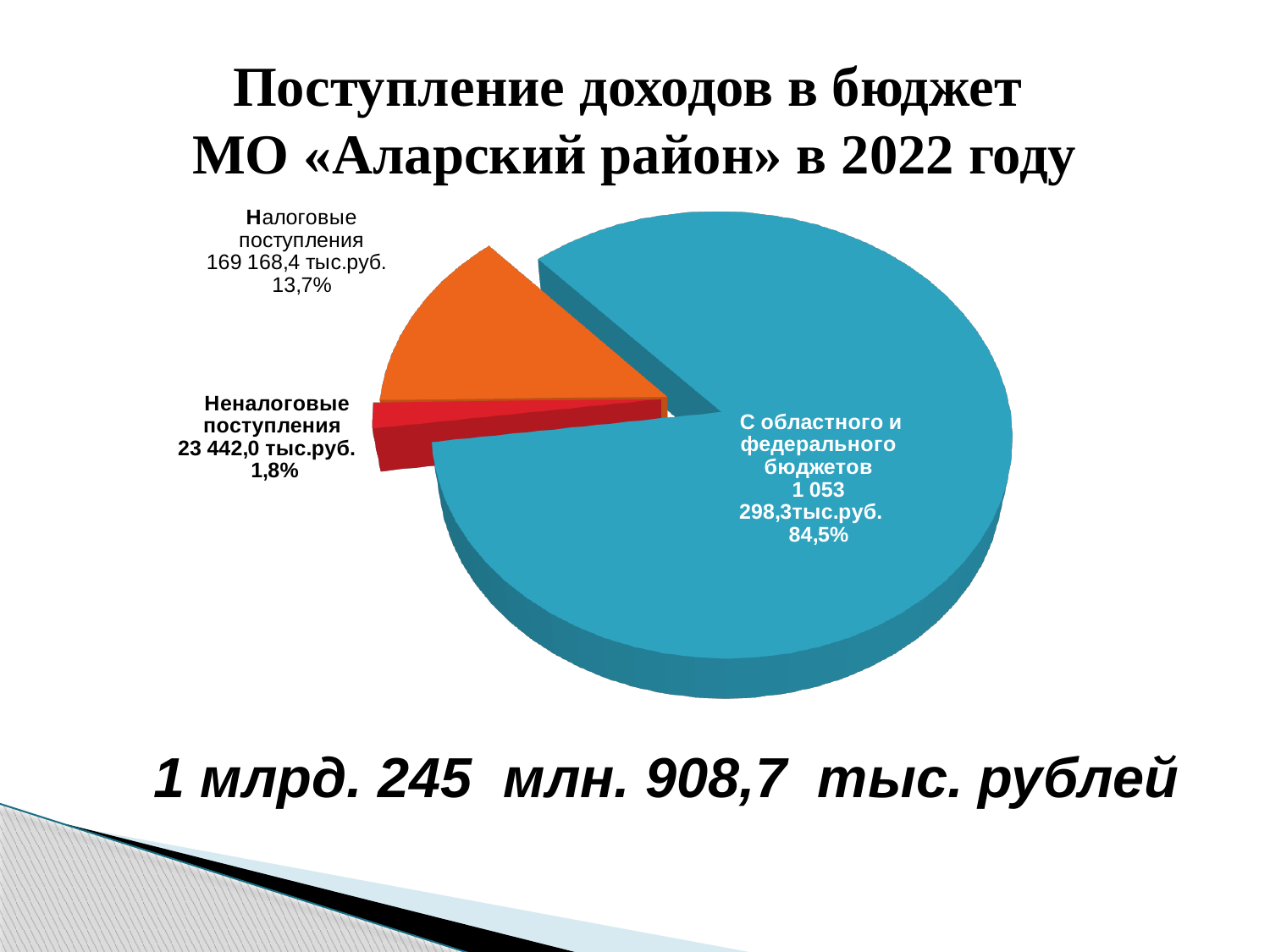
What share of the pie does Налоговые поступления represent? 13,7% What colour is the slice for С областного и федерального бюджетов? Blue Which category has the smallest slice of the pie? Неналоговые поступления What share of the pie does С областного и федерального бюджетов represent? 84,5% What is the value for Неналоговые поступления? 23 442,0 тыс.руб. What kind of chart is shown on the slide? Pie chart What is the value for С областного и федерального бюджетов? 1 053 298,3 тыс.руб. Which category has the largest slice of the pie? С областного и федерального бюджетов What share of the pie does Неналоговые поступления represent? 1,8% Which is larger, Налоговые поступления or Неналоговые поступления? Налоговые поступления What is the value for Налоговые поступления? 169 168,4 тыс.руб. How many slices does the pie chart have? 3